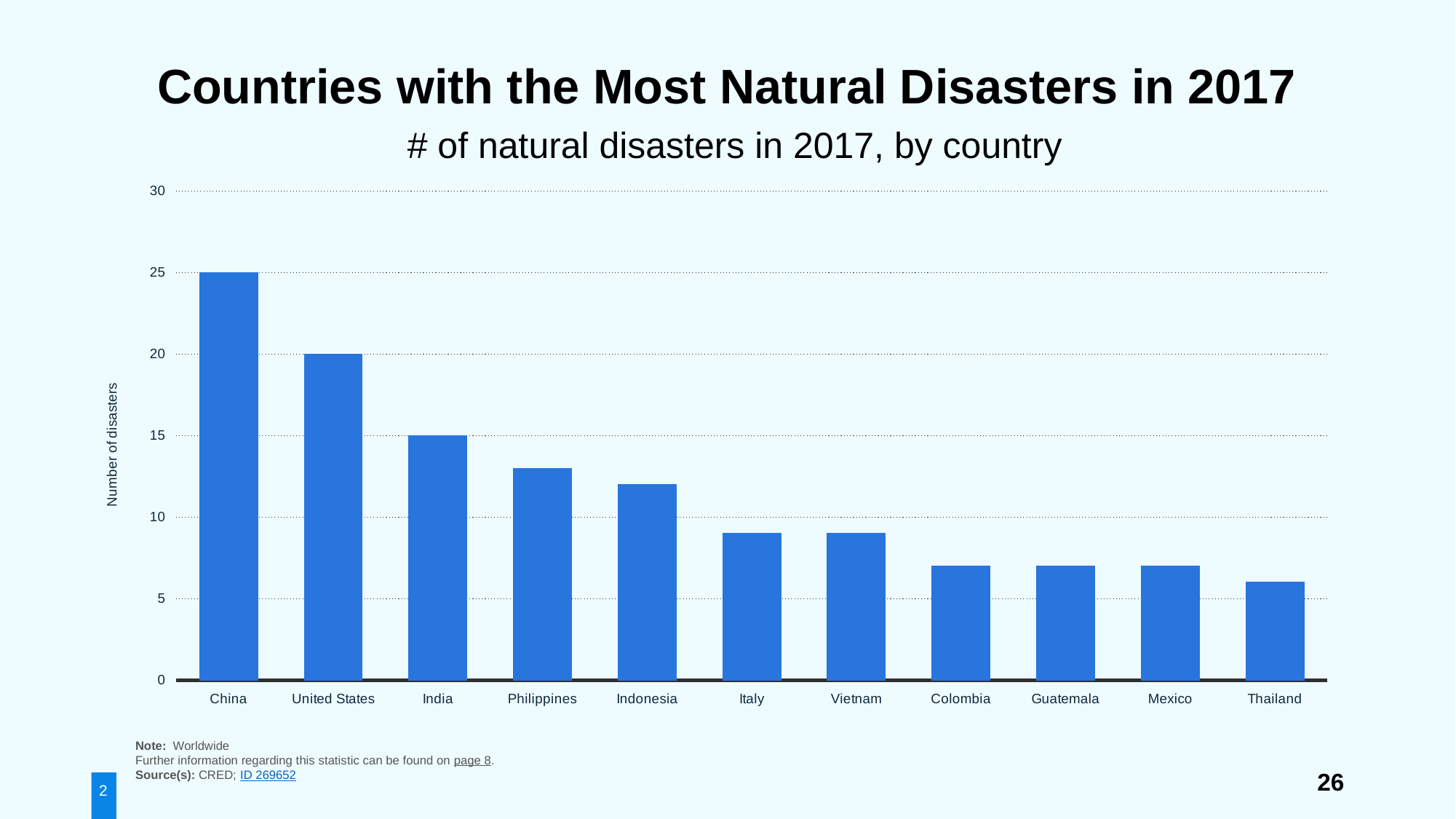
Do the values rise or fall from left to right across the countries? Fall Is the value for Thailand greater or less than 10? less Which country has the lowest number of natural disasters in 2017? Thailand How many natural disasters did China have in 2017? 25 Is the value for Indonesia greater or less than 10? greater How many countries are shown in the chart? 11 How many natural disasters did the United States have in 2017? 20 How many natural disasters did India have in 2017? 15 Which had more natural disasters in 2017, the Philippines or Italy? Philippines What is the difference between the number of natural disasters in China and in the United States? 5 Which country has the highest number of natural disasters in 2017? China What type of chart is shown on the slide? Bar chart